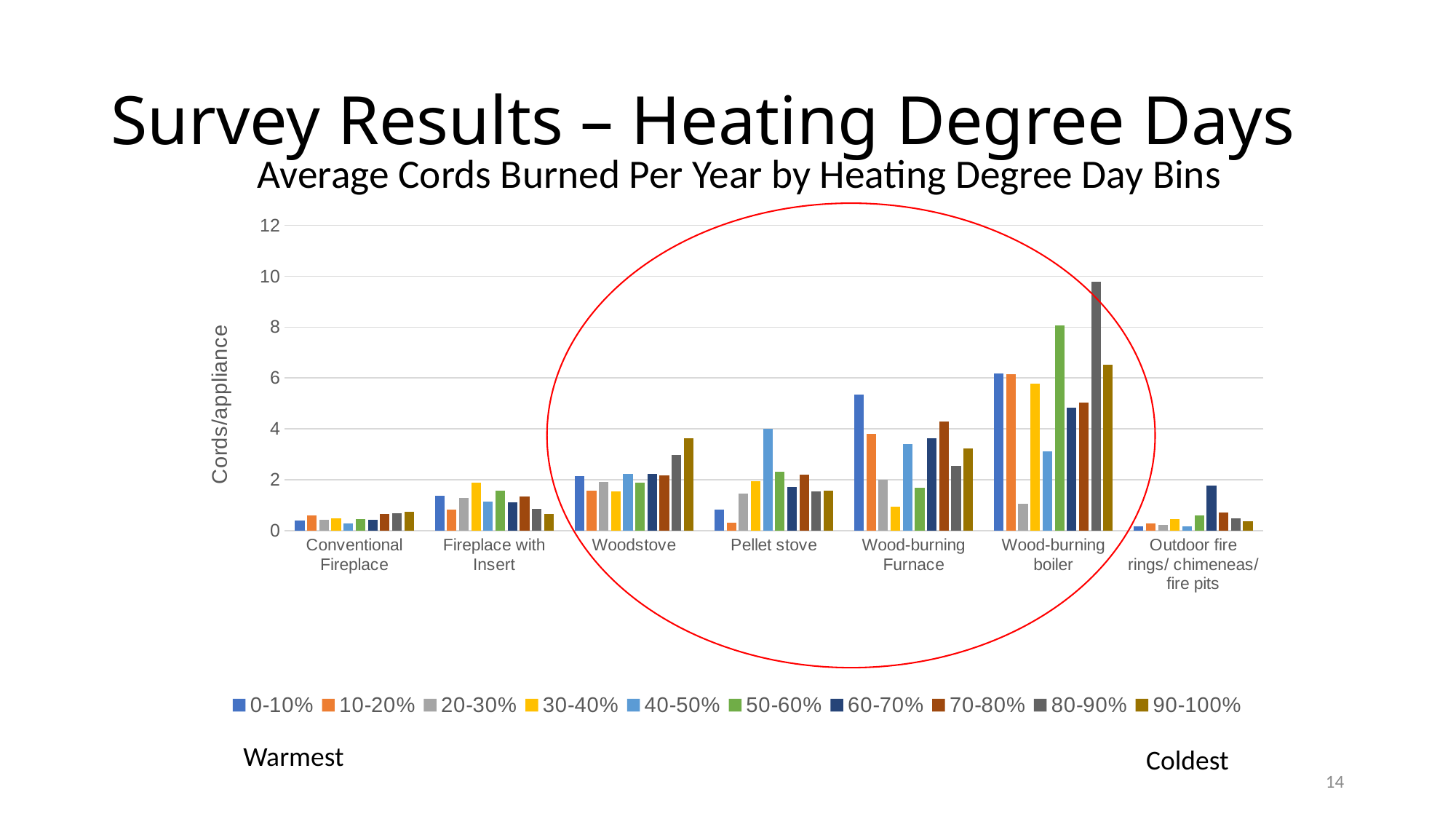
How many appliance categories are shown on the x axis? 7 Which is larger: the 50-60% bin for Wood-burning boiler or the 0-10% bin for Wood-burning Furnace? 50-60% bin for Wood-burning boiler What is the title of the chart? Average Cords Burned Per Year by Heating Degree Day Bins What kind of chart is shown on the slide? Bar chart Is the value for the 80-90% bin for Wood-burning boiler greater or less than 8? greater Is the value for the 0-10% bin for Conventional Fireplace greater or less than 2? less Is the value for the 0-10% bin for Wood-burning Furnace greater or less than 4? greater What is the label on the vertical axis? Cords/appliance How many series does the legend list? 10 Which appliance category contains the tallest bar in the chart? Wood-burning boiler For Wood-burning boiler, which heating degree day bin has the highest value? 80-90% For Pellet stove, which heating degree day bin has the highest value? 40-50%